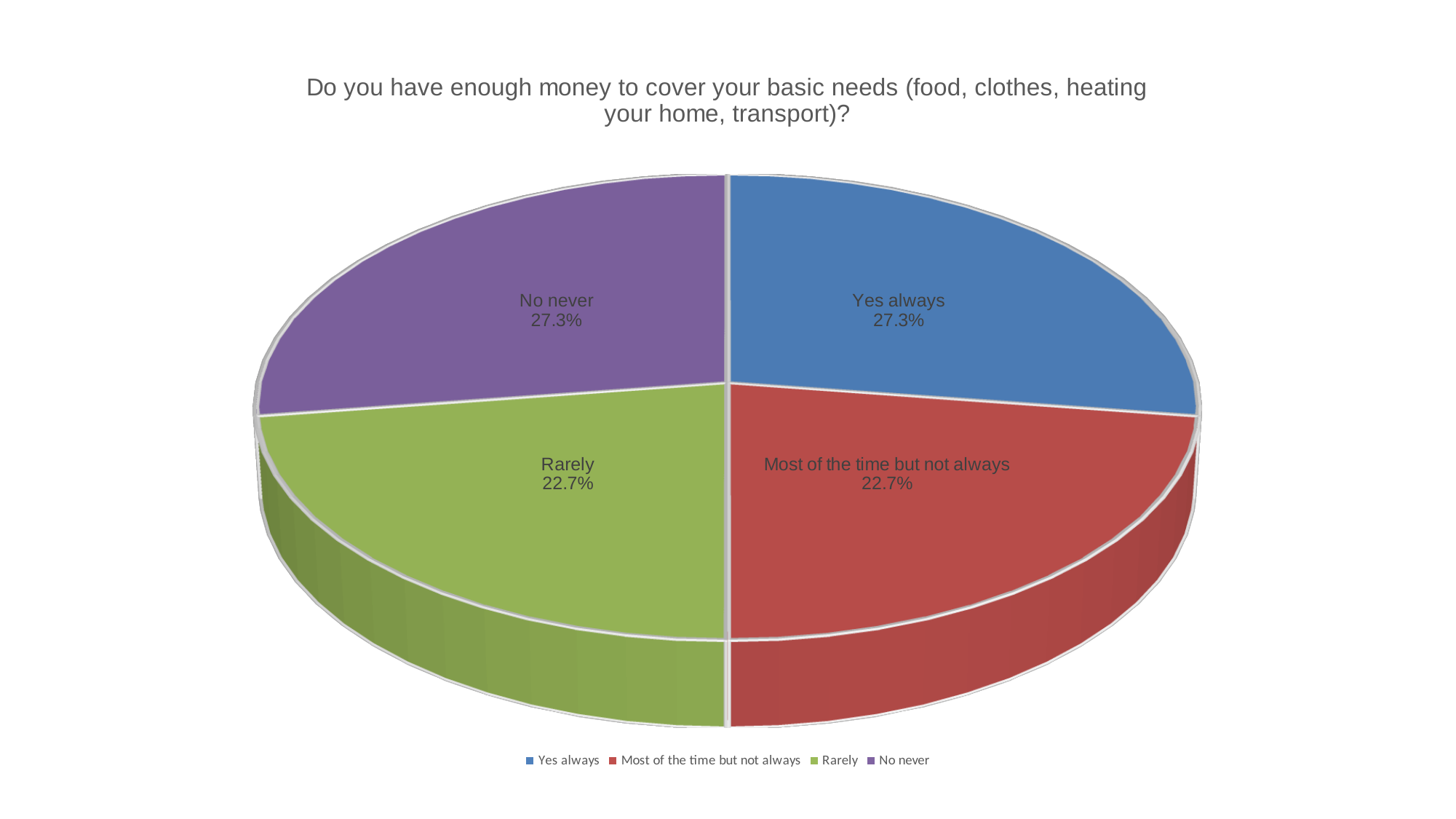
What kind of chart is shown on the slide? Pie chart What is the value shown for "No never"? 27.3% What share of the pie does the "Yes always" slice represent? 27.3% How many slices does the pie chart have? 4 What is the value shown for "Most of the time but not always"? 22.7% What colour is the "Rarely" slice? Green What is the title of the chart? Do you have enough money to cover your basic needs (food, clothes, heating your home, transport)? How many entries does the legend list? 4 What share of the pie does the "Rarely" slice represent? 22.7% What is the difference between the "No never" share and the "Most of the time but not always" share? 4.6% What is the combined share of "Yes always" and "No never"? 54.6% Which is larger, the "Yes always" slice or the "Rarely" slice? Yes always